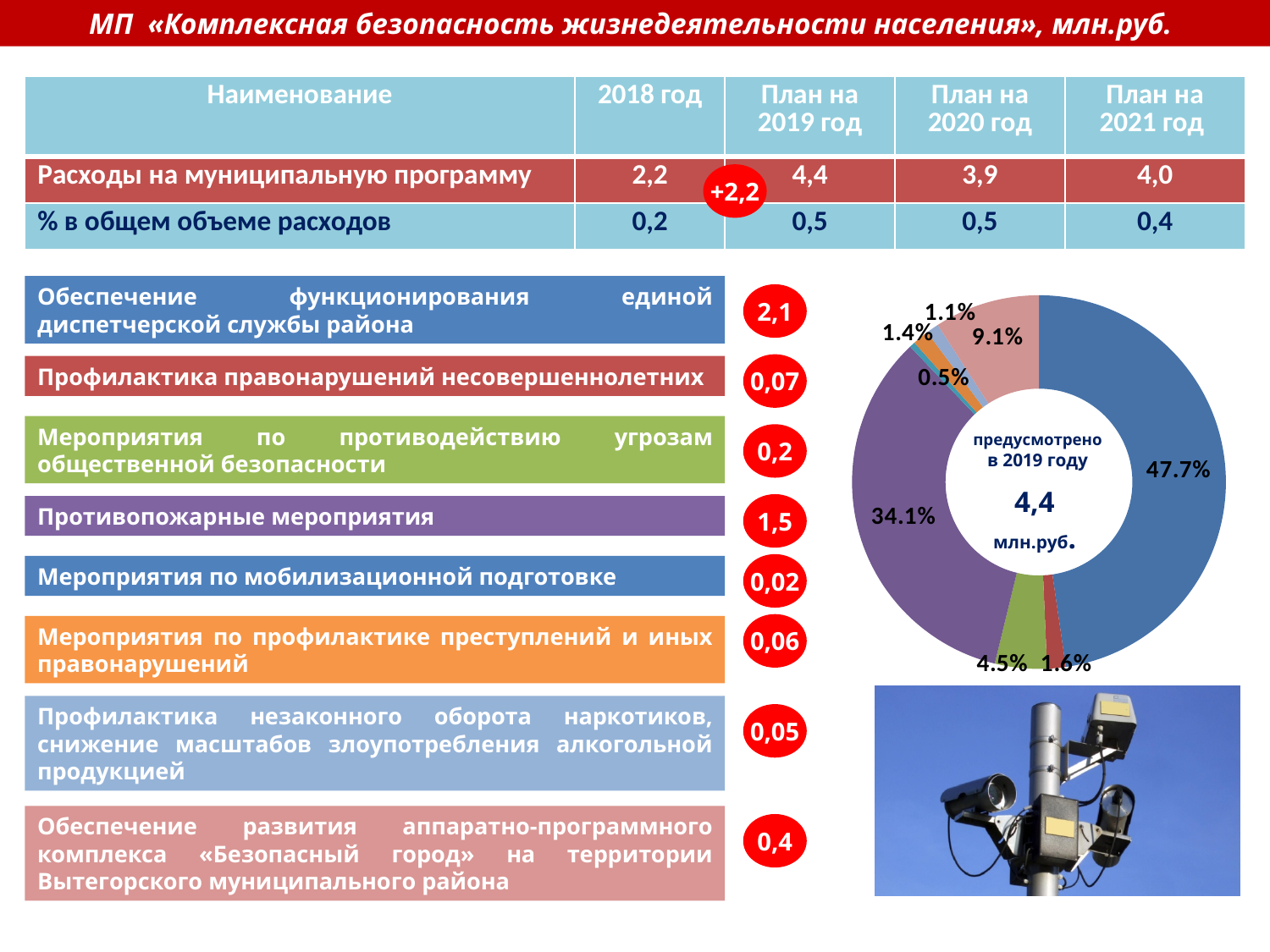
What kind of chart is shown on the right side of the slide? pie chart (doughnut) How many slices does the doughnut chart have? 8 What is the largest share shown on the doughnut chart? 47.7% What is the smallest share shown on the doughnut chart? 0.5% What share does the purple slice of the doughnut chart represent? 34.1% Which slice is larger on the doughnut chart: the one labelled 4.5% or the one labelled 1.6%? 4.5% What share does the green slice of the doughnut chart represent? 4.5% What total amount in million rubles is shown in the centre of the doughnut chart? 4,4 What share does the pink slice of the doughnut chart represent? 9.1% What is the difference between the largest slice (47.7%) and the second largest slice (34.1%) on the doughnut chart? 13.6% According to the text in the centre of the doughnut chart, for which year is the amount planned? 2019 Is the share of the largest slice on the doughnut chart greater or less than 50%? less